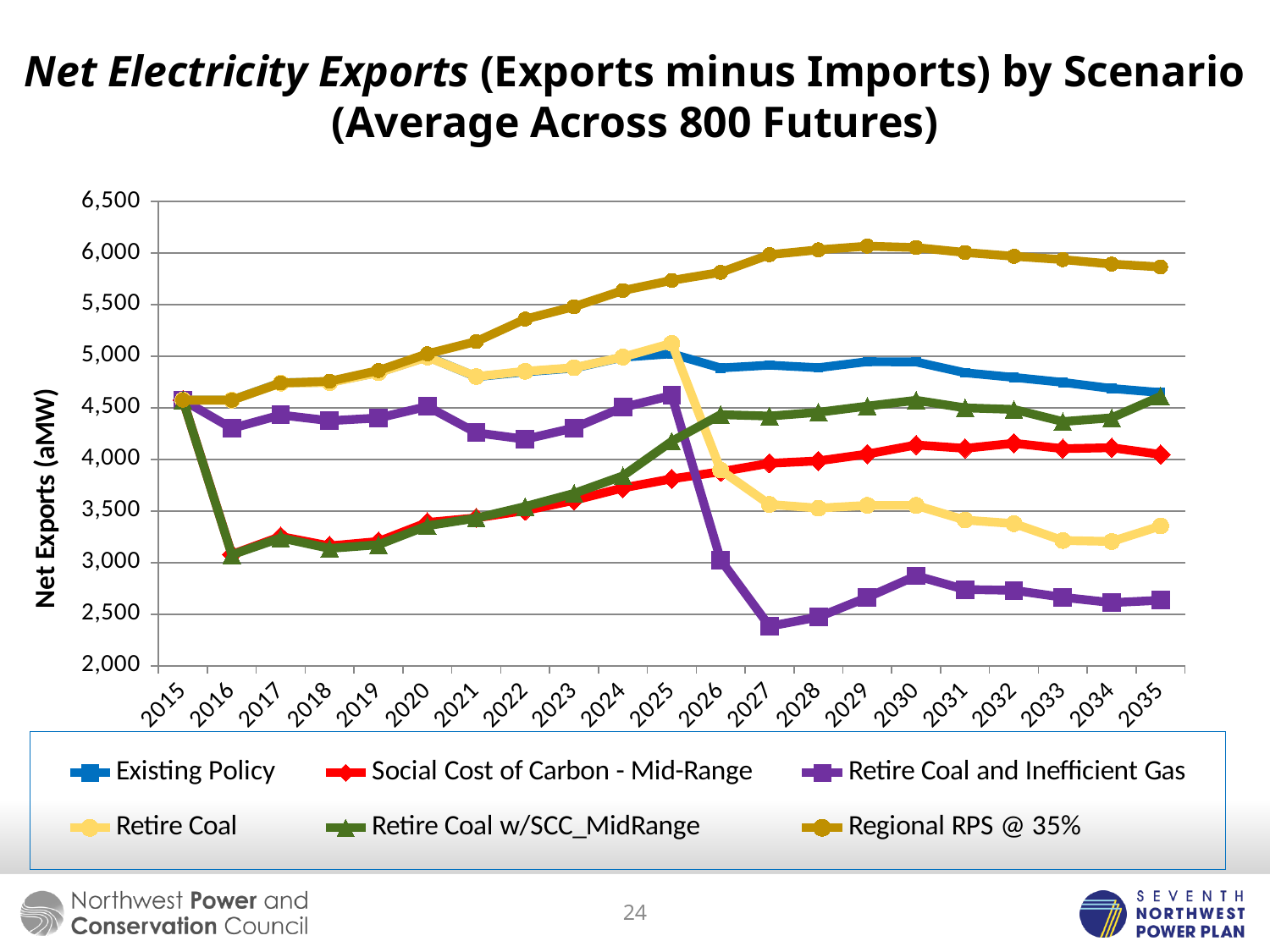
Does the Regional RPS @ 35% series rise or fall from 2015 to 2029? Rise Is the value for Retire Coal in 2034 greater or less than 3,500? less In 2030, which is larger: Retire Coal or Retire Coal and Inefficient Gas? Retire Coal What kind of chart is shown on the slide? Line chart Which series has the highest value in 2035? Regional RPS @ 35% Which series has the lowest value in 2035? Retire Coal and Inefficient Gas How many years are plotted along the x axis? 21 In 2020, which is larger: Existing Policy or Social Cost of Carbon - Mid-Range? Existing Policy Is the value for Regional RPS @ 35% in 2025 greater or less than 5,500? greater How many series does the legend list? 6 What is the label on the y axis? Net Exports (aMW) Is the value for Retire Coal and Inefficient Gas in 2027 greater or less than 2,500? less